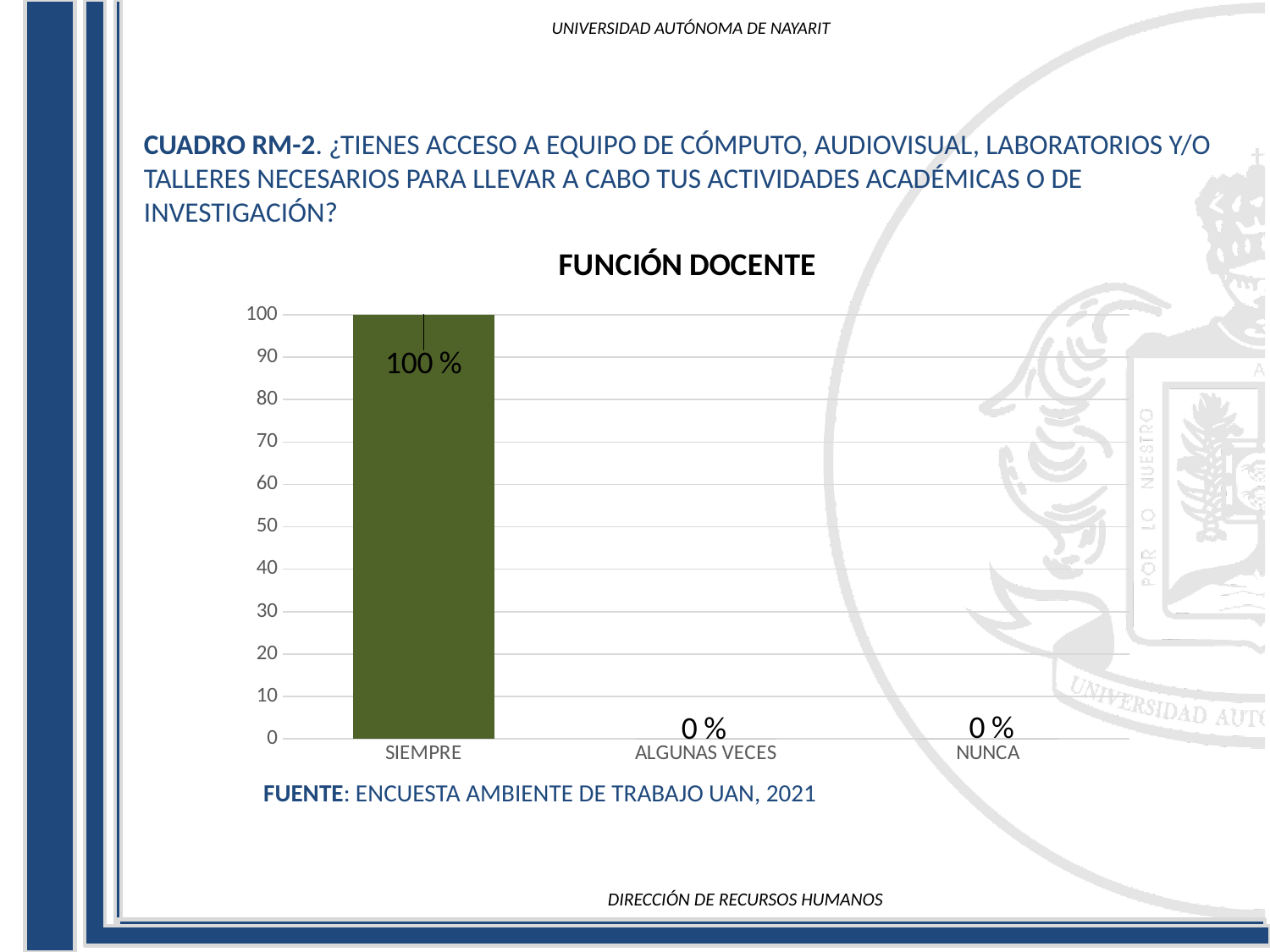
What is the difference between the values for SIEMPRE and NUNCA? 100 % What is the value for NUNCA? 0 % What is the title of the chart? FUNCIÓN DOCENTE Which category has the highest value? SIEMPRE What is the highest tick value shown on the y axis? 100 What is the value for SIEMPRE? 100 % What is the value for ALGUNAS VECES? 0 % What is the source cited below the chart? ENCUESTA AMBIENTE DE TRABAJO UAN, 2021 Which is larger, the value for SIEMPRE or the value for ALGUNAS VECES? SIEMPRE Is the value for SIEMPRE greater or less than 50? greater What kind of chart is shown? bar chart How many categories are shown on the x axis? 3